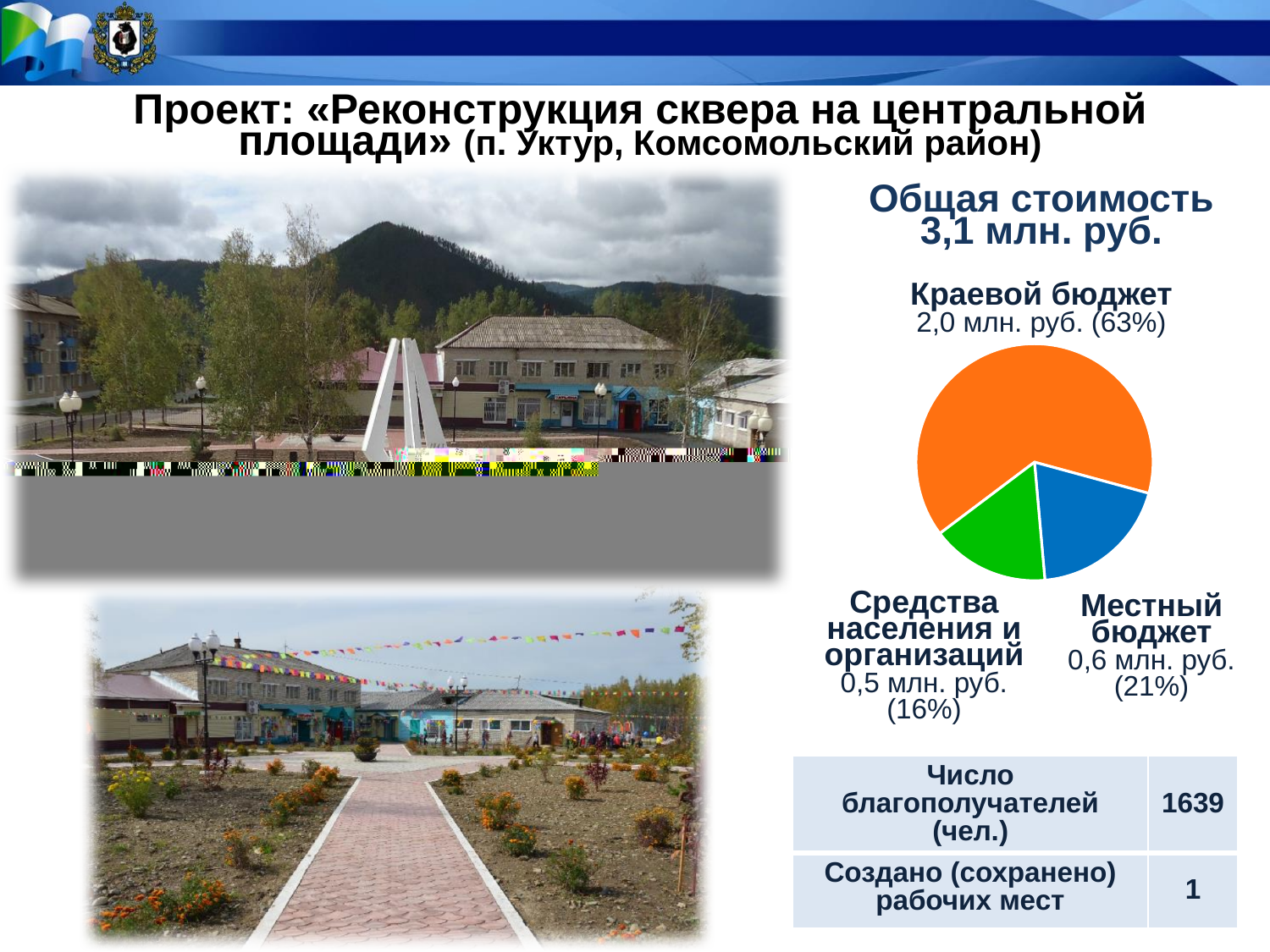
What is the value for Средства населения и организаций in the pie chart? 0,5 млн. руб. What kind of chart is shown on the slide? pie chart How many slices does the pie chart have? 3 Which slice of the pie chart is the largest? Краевой бюджет What share of the pie does Местный бюджет represent? 21% What share of the pie does Краевой бюджет represent? 63% What share of the pie does Средства населения и организаций represent? 16% Which slice of the pie chart is the smallest? Средства населения и организаций Which colour is used for the Краевой бюджет slice in the pie chart? orange What is the difference in percentage points between the Краевой бюджет share and the Местный бюджет share? 42 What is the value for Краевой бюджет in the pie chart? 2,0 млн. руб. What is the value for Местный бюджет in the pie chart? 0,6 млн. руб.